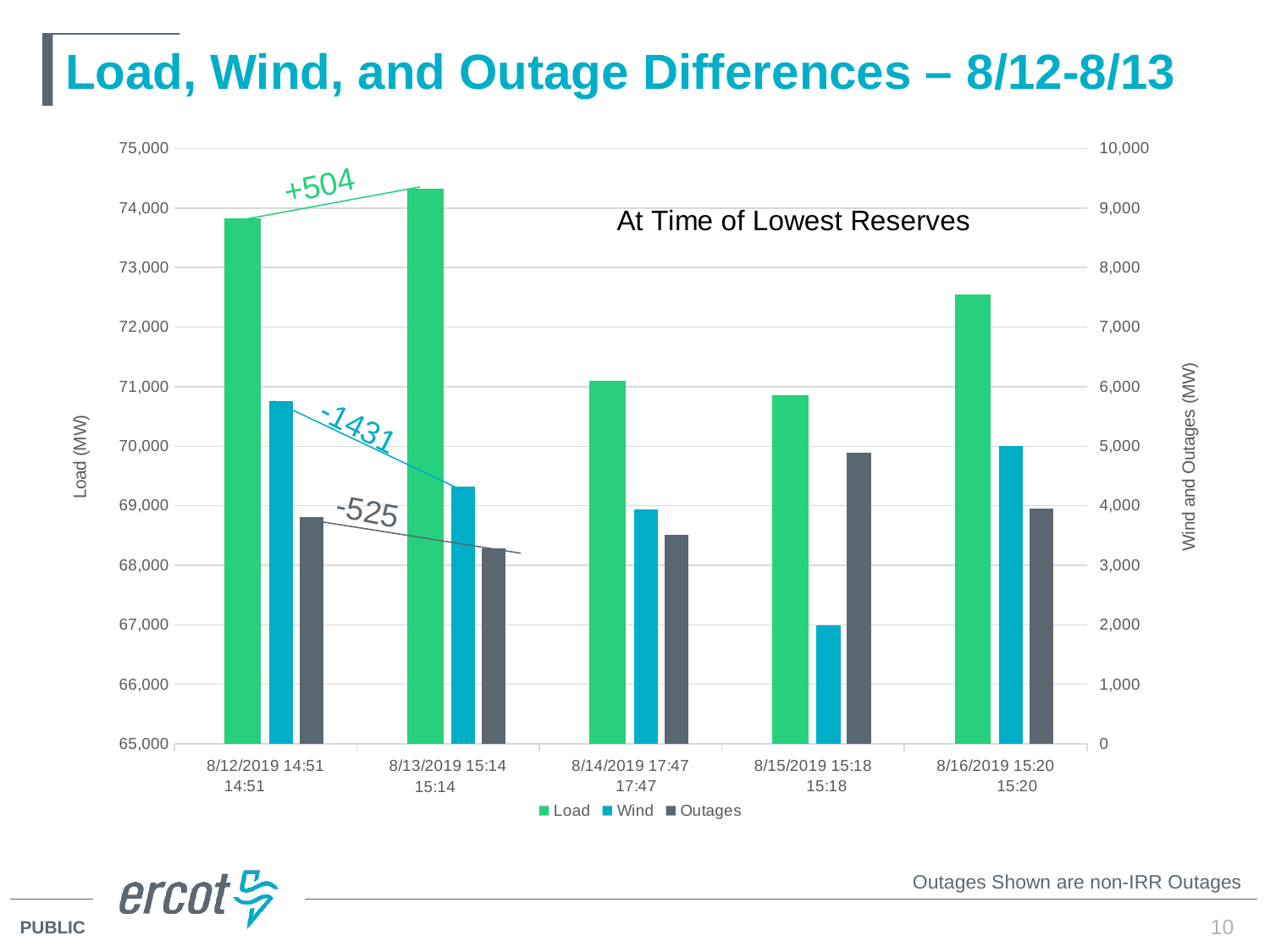
Which is larger, the Load on 8/12/2019 14:51 or the Load on 8/16/2019 15:20? 8/12/2019 14:51 How many time points (categories) are shown on the x axis? 5 What kind of chart is shown on the slide? bar chart According to the annotation, what is the change in Outages from 8/12/2019 14:51 to 8/13/2019 15:14? -525 On which date is the Wind lowest? 8/15/2019 15:18 Is the Load value for 8/12/2019 14:51 greater or less than 73,000? greater According to the annotation, what is the change in Load from 8/12/2019 14:51 to 8/13/2019 15:14? +504 Is the Outages value for 8/15/2019 15:18 greater or less than 4,000? greater How many series does the legend list? 3 According to the annotation, what is the change in Wind from 8/12/2019 14:51 to 8/13/2019 15:14? -1431 On which date is the Load highest? 8/13/2019 15:14 On which date are the Outages highest? 8/15/2019 15:18